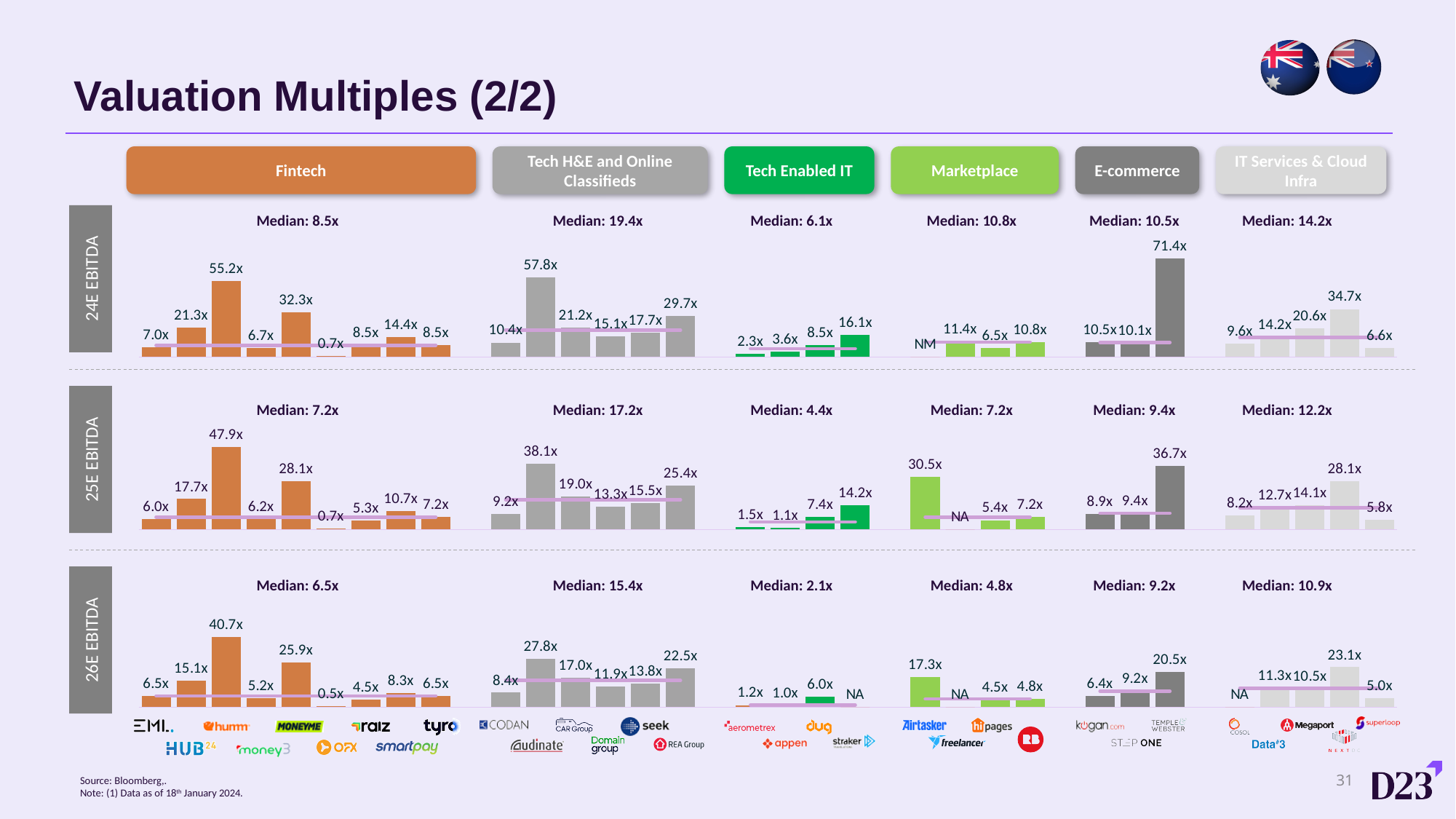
For 25E EBITDA, which group has the higher median: Tech Enabled IT or Marketplace? Marketplace How many bars are plotted in the Fintech 24E EBITDA chart? 9 In the Fintech 26E EBITDA chart, what is the lowest multiple shown? 0.5x How many sector groups are shown across the top of the slide? 6 In the E-commerce 24E EBITDA chart, what is the highest multiple shown? 71.4x What is the median 26E EBITDA multiple for the Tech H&E and Online Classifieds group? 15.4x Which group has the highest median 24E EBITDA multiple on the slide? Tech H&E and Online Classifieds In the Tech H&E and Online Classifieds 24E EBITDA chart, what is the difference between the highest multiple (57.8x) and the lowest multiple (10.4x)? 47.4x In the Marketplace 25E EBITDA chart, what is the highest multiple shown? 30.5x What kind of chart is used to show the valuation multiples on this slide? Bar chart Do the medians for IT Services & Cloud Infra rise or fall from 24E EBITDA to 26E EBITDA? Fall What is the median 24E EBITDA multiple shown for the Fintech group? 8.5x